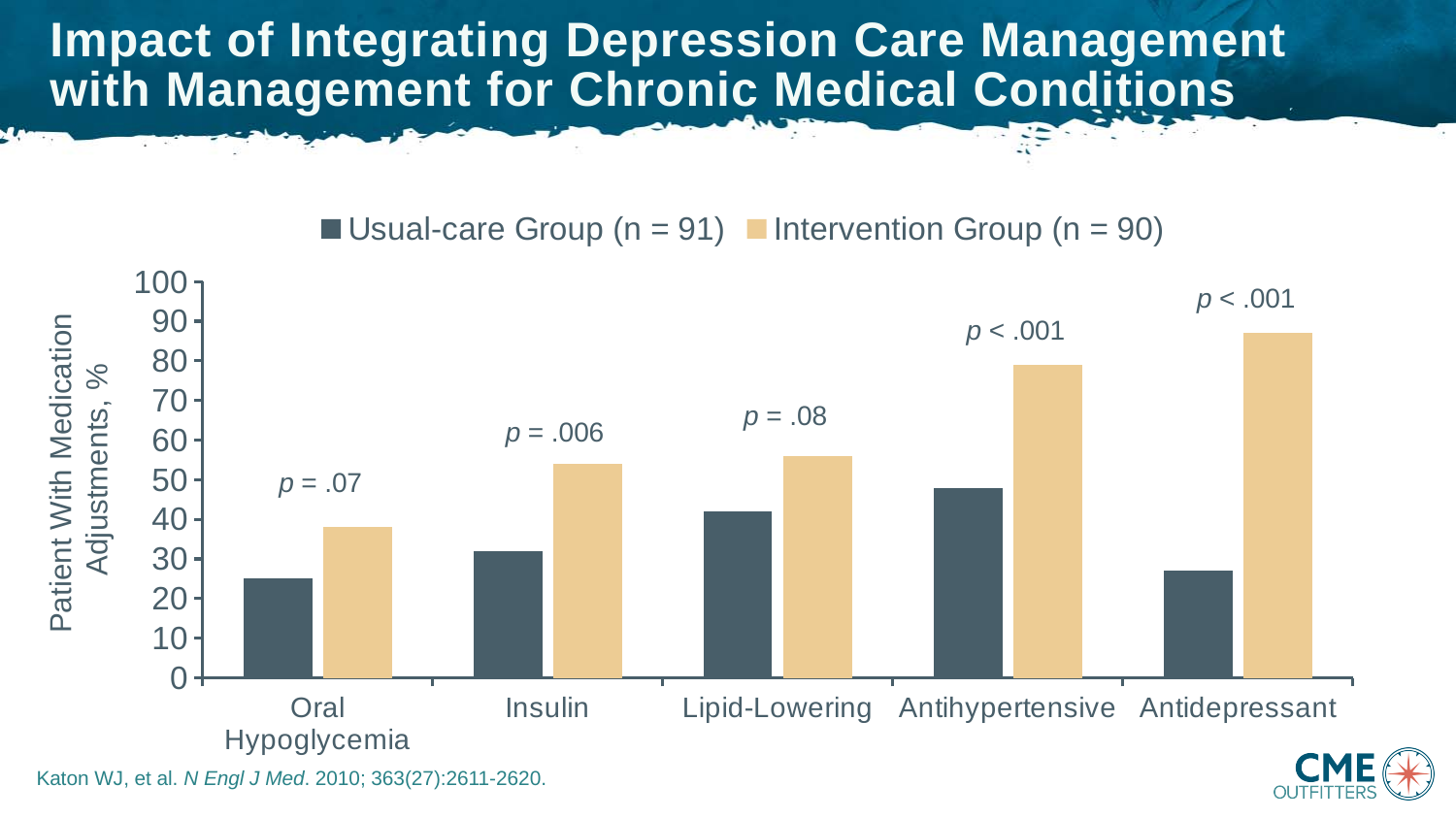
How many medication categories are shown on the x axis? 5 Which is larger: the Usual-care Group value for Insulin or for Lipid-Lowering? Lipid-Lowering Which category has the highest value for the Intervention Group? Antidepressant Which category has the highest value for the Usual-care Group? Antihypertensive What is the sample size (n) of the Usual-care Group according to the legend? 91 Is the Intervention Group value for Antidepressant greater or less than 80? greater Is the Intervention Group value for Insulin greater or less than 50? greater What p-value is shown above the Antidepressant bars? p < .001 How many series does the legend list? 2 What kind of chart is shown on the slide? Bar chart Which category has the lowest value for the Intervention Group? Oral Hypoglycemia Is the Usual-care Group value for Oral Hypoglycemia greater or less than 30? less